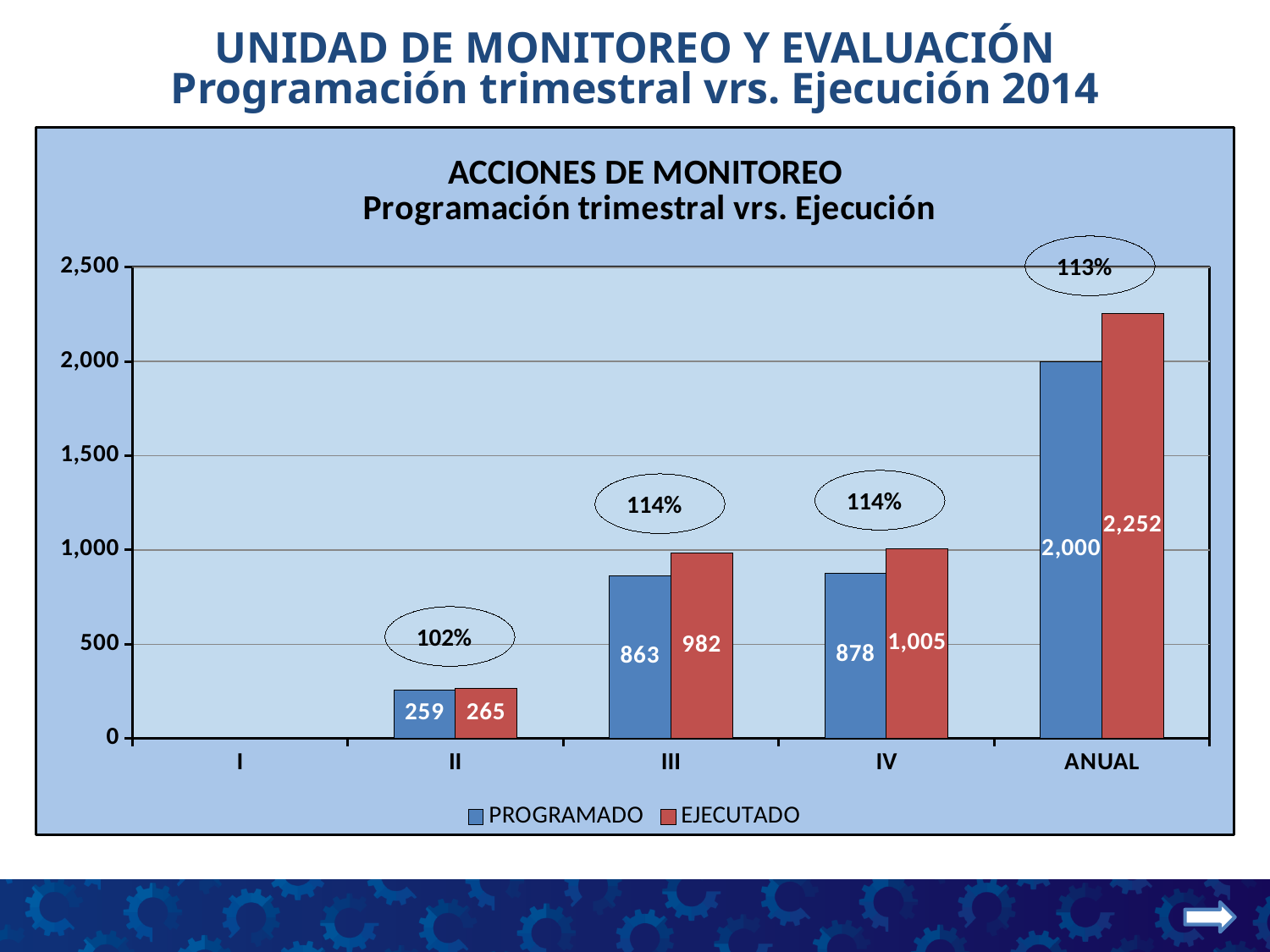
What is the PROGRAMADO value for quarter II? 259 What is the EJECUTADO value for ANUAL? 2,252 Is the EJECUTADO value for ANUAL greater or less than 2,000? greater What is the difference between the EJECUTADO and PROGRAMADO values for ANUAL? 252 What kind of chart is shown on the slide? Bar chart Which is larger for quarter III, PROGRAMADO or EJECUTADO? EJECUTADO Which category has the highest EJECUTADO value? ANUAL How many series does the legend list? 2 What percentage is shown in the circle above the ANUAL bars? 113% Among the quarters II, III and IV, which has the lowest PROGRAMADO value? II What is the PROGRAMADO value for quarter III? 863 What is the EJECUTADO value for quarter IV? 1,005